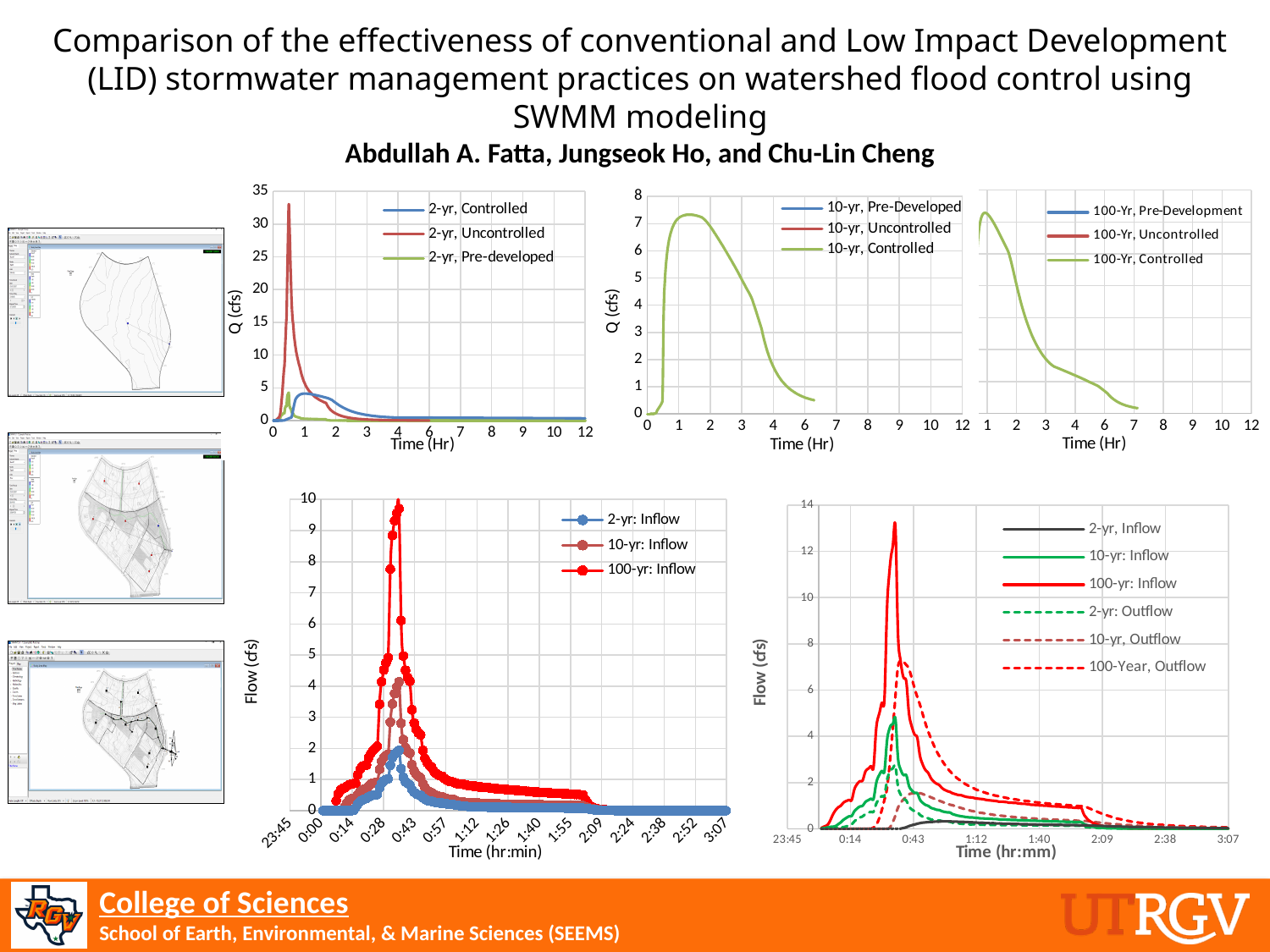
In the top-left chart (2-yr), how many series does the legend list? 3 In the bottom-middle chart (Flow vs Time (hr:min)), which series reaches the highest peak flow? 100-yr: Inflow In the bottom-right chart (Flow vs Time (hr:mm)), is the peak value of the 100-yr: Inflow series greater or less than 12? greater In the bottom-middle chart (Flow vs Time (hr:min)), which series has the lowest peak flow? 2-yr: Inflow In the bottom-right chart (Flow vs Time (hr:mm)), which is larger at its peak: 100-yr: Inflow or 100-Year, Outflow? 100-yr: Inflow What is the y-axis label of the top-middle chart (10-yr)? Q (cfs) In the bottom-middle chart (Flow vs Time (hr:min)), is the peak value of the 100-yr: Inflow series greater or less than 9? greater In the bottom-right chart (Flow vs Time (hr:mm)), how many series does the legend list? 6 What kind of chart is the top-left chart showing 2-yr Controlled, Uncontrolled and Pre-developed? Line chart In the top-middle chart (10-yr), is the peak value of the curve greater or less than 6? greater In the top-left chart (2-yr), which series reaches the highest peak Q (cfs)? 2-yr, Uncontrolled